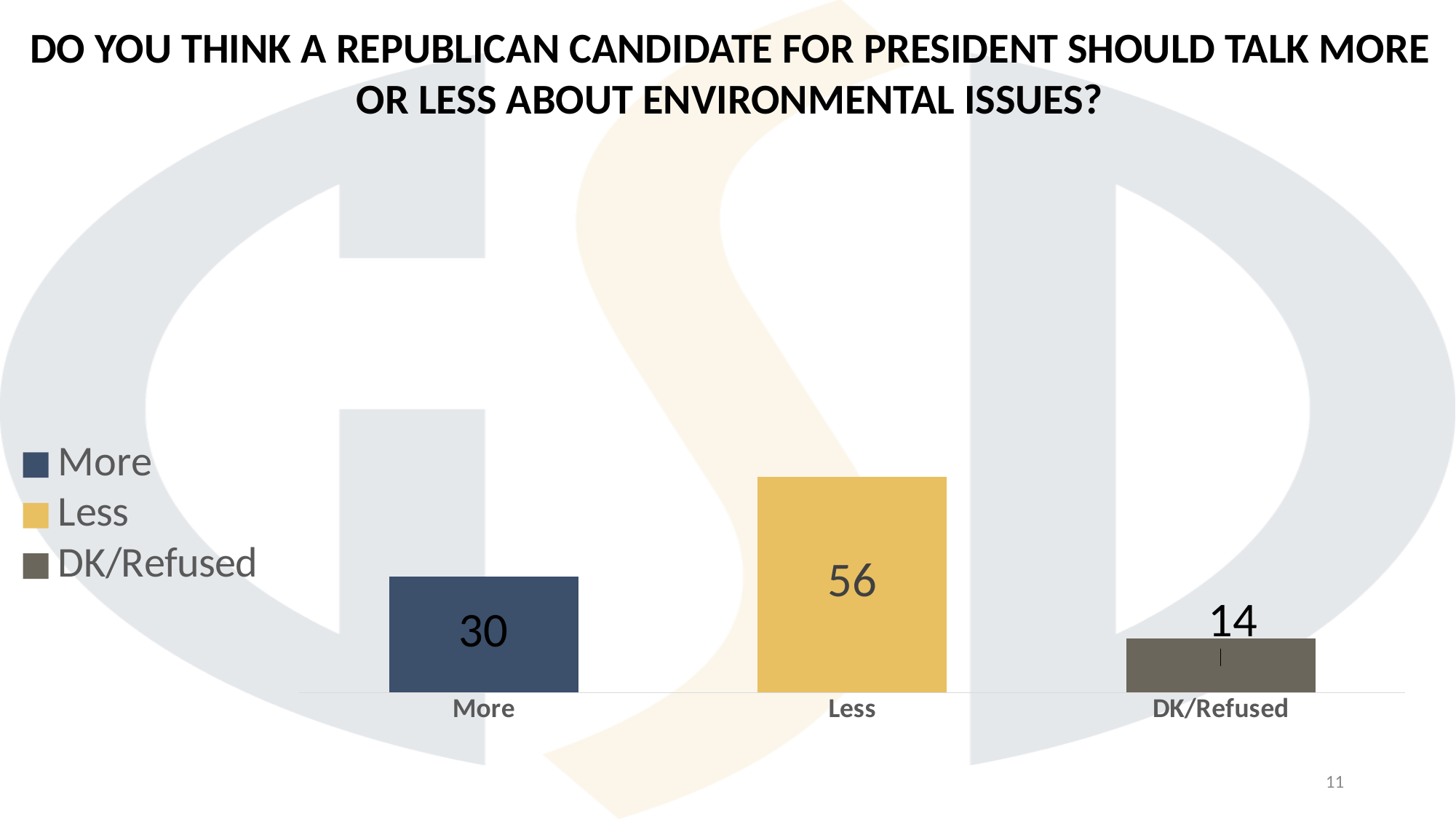
Which category has the highest value? Less What is the value for "More"? 30 Which is larger, the value for "More" or the value for "Less"? Less What is the difference between the values for "More" and "DK/Refused"? 16 What is the value for "DK/Refused"? 14 What is the value for "Less"? 56 Which category has the lowest value? DK/Refused What is the difference between the values for "Less" and "More"? 26 What kind of chart is shown on the slide? Bar chart How many categories are shown in the chart? 3 How many entries does the legend list? 3 What colour is the bar for "Less"? Yellow